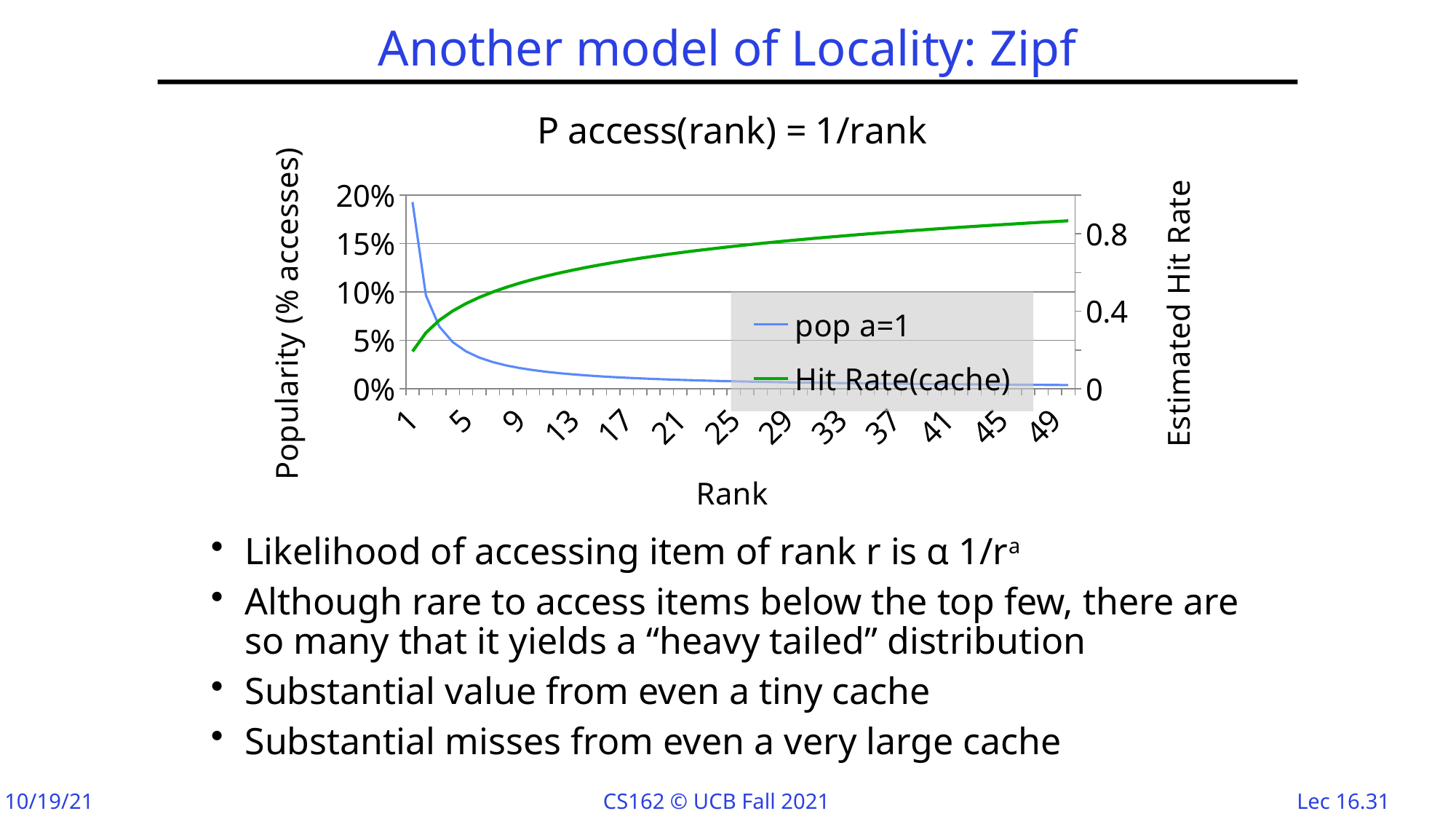
Is the value of 'pop a=1' at rank 9 greater or less than 5%? less How many tick labels are shown on the x axis? 13 Does the 'Hit Rate(cache)' series rise or fall as rank increases? rise What kind of chart is shown on the slide? line chart Is the value of 'pop a=1' at rank 1 greater or less than 15%? greater Is the value of 'Hit Rate(cache)' at rank 1 greater or less than 0.4? less What is the title of the chart? P access(rank) = 1/rank What is the label of the x axis? Rank Does the 'pop a=1' series rise or fall as rank increases? fall How many series does the chart legend list? 2 Which series is plotted in green? Hit Rate(cache)